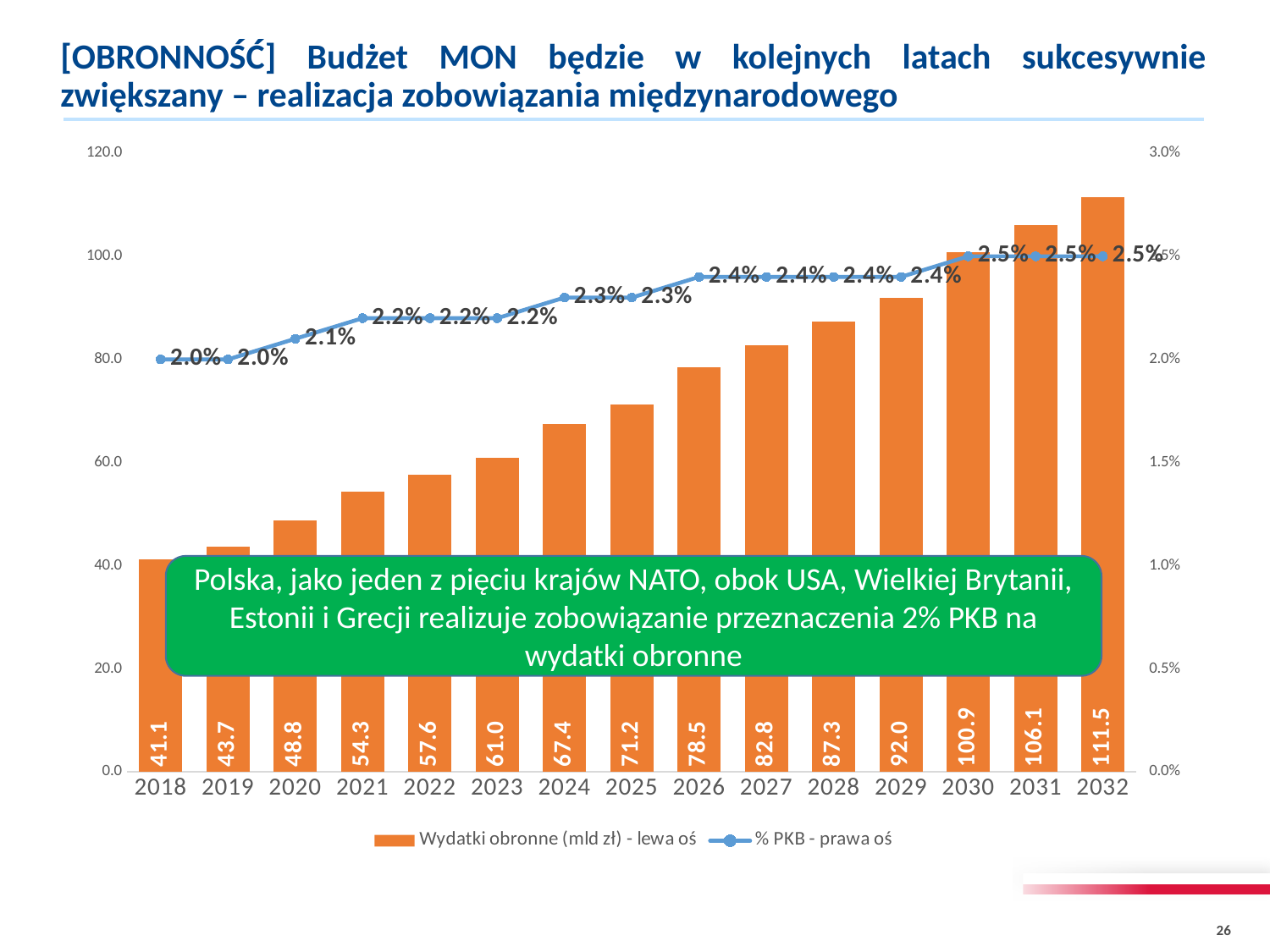
How many years are shown on the x axis? 15 Which year has the highest value of Wydatki obronne (mld zł)? 2032 Do the Wydatki obronne values rise or fall from 2018 to 2032? Rise Which year has the lowest value of Wydatki obronne (mld zł)? 2018 What is the difference in Wydatki obronne (mld zł) between 2032 and 2018? 70.4 Which is larger, the Wydatki obronne value for 2025 or for 2026? 2026 What is the % PKB value for 2032? 2.5% What is the value of Wydatki obronne (mld zł) for 2030? 100.9 How many series does the legend list? 2 What kind of chart is shown on the slide? Combined bar and line chart What is the % PKB value for 2024? 2.3% What is the value of Wydatki obronne (mld zł) for 2018? 41.1